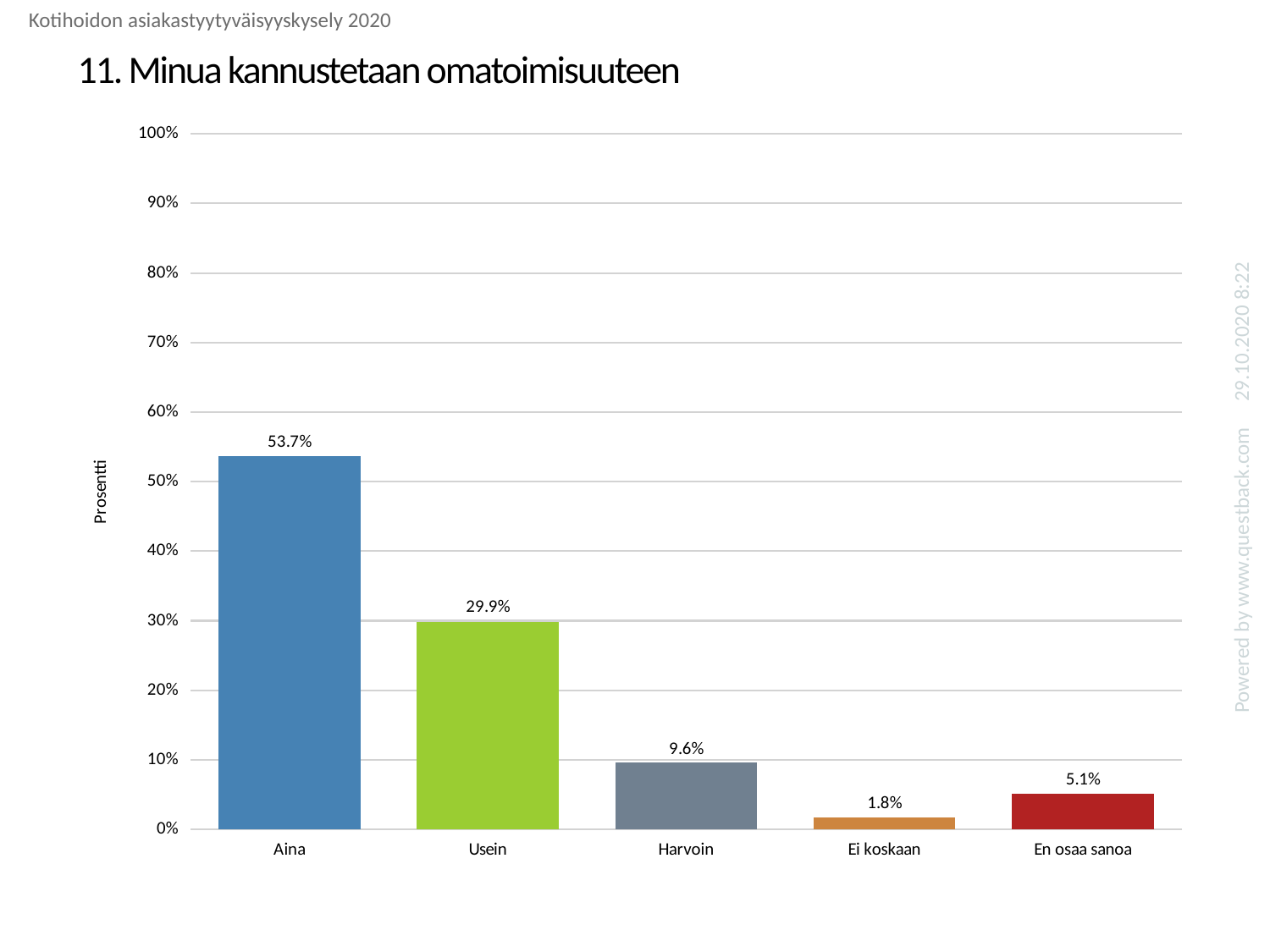
Which category has the lowest value? Ei koskaan What is the value for Usein? 29.9% Is the value for Usein greater or less than 40%? less What is the value for En osaa sanoa? 5.1% Which category has the highest value? Aina What is the value for Ei koskaan? 1.8% What is the difference between the values for Aina and Usein? 23.8% Which is larger, the value for Harvoin or the value for En osaa sanoa? Harvoin What kind of chart is shown on the slide? bar chart What is the value for Aina? 53.7% What is the value for Harvoin? 9.6% How many categories are shown on the x axis? 5